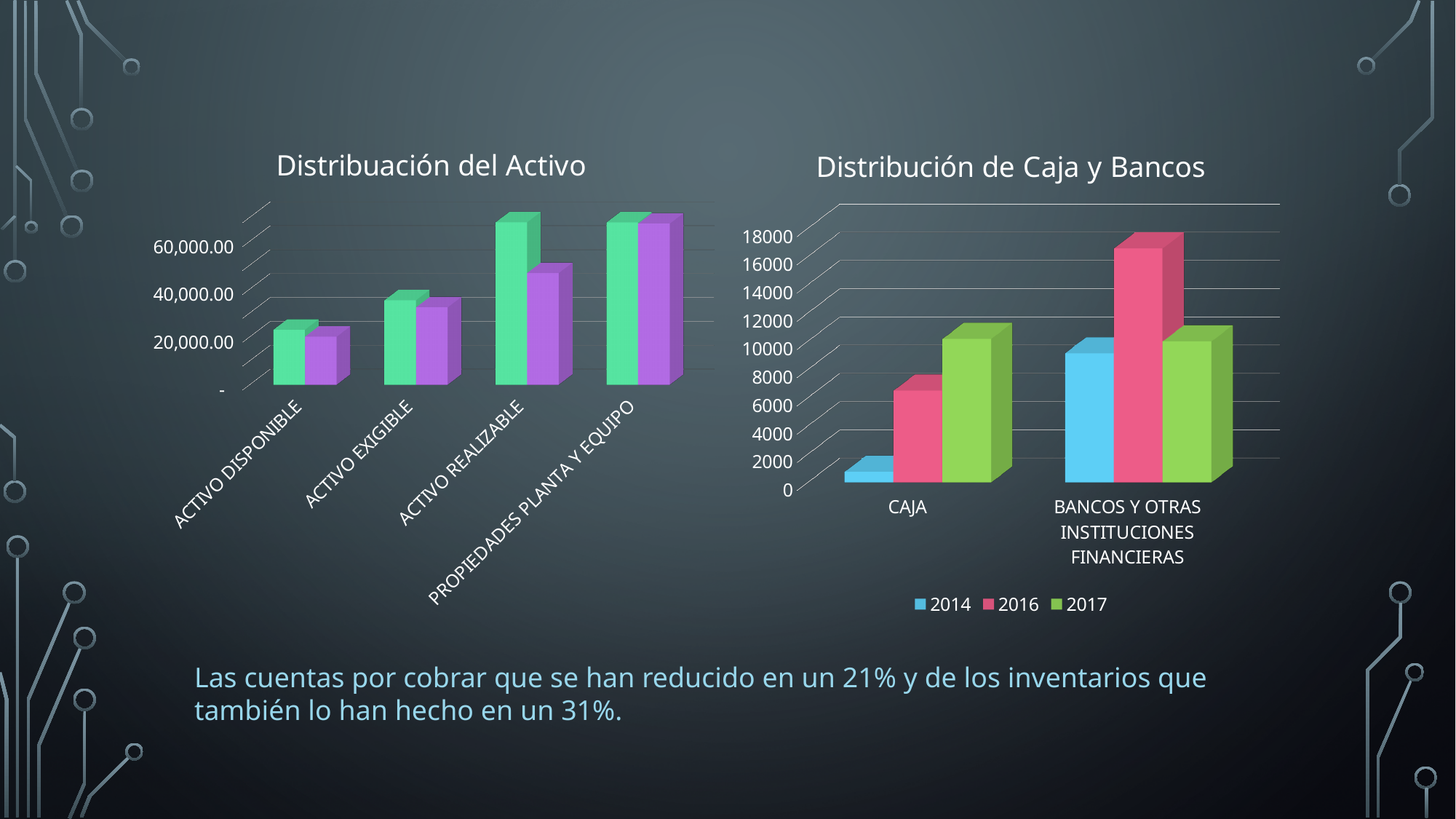
In "Distribución de Caja y Bancos", is the 2014 value for CAJA greater or less than 2000? less In "Distribuación del Activo", is the green bar for ACTIVO REALIZABLE greater or less than 60,000.00? greater In "Distribuación del Activo", which is larger for ACTIVO REALIZABLE, the green bar or the purple bar? the green bar In "Distribuación del Activo", which category has the highest purple bar? PROPIEDADES PLANTA Y EQUIPO In "Distribuación del Activo", is the purple bar for ACTIVO DISPONIBLE greater or less than 40,000.00? less In "Distribución de Caja y Bancos", which year has the highest bar for BANCOS Y OTRAS INSTITUCIONES FINANCIERAS? 2016 What kind of chart is "Distribuación del Activo"? bar chart How many categories are shown on the x axis of "Distribuación del Activo"? 4 In "Distribuación del Activo", which category has the lowest green bar? ACTIVO DISPONIBLE In "Distribución de Caja y Bancos", which year has the lowest bar for CAJA? 2014 In "Distribución de Caja y Bancos", do the CAJA values rise or fall from 2014 to 2017? rise How many series does the legend of "Distribución de Caja y Bancos" list? 3